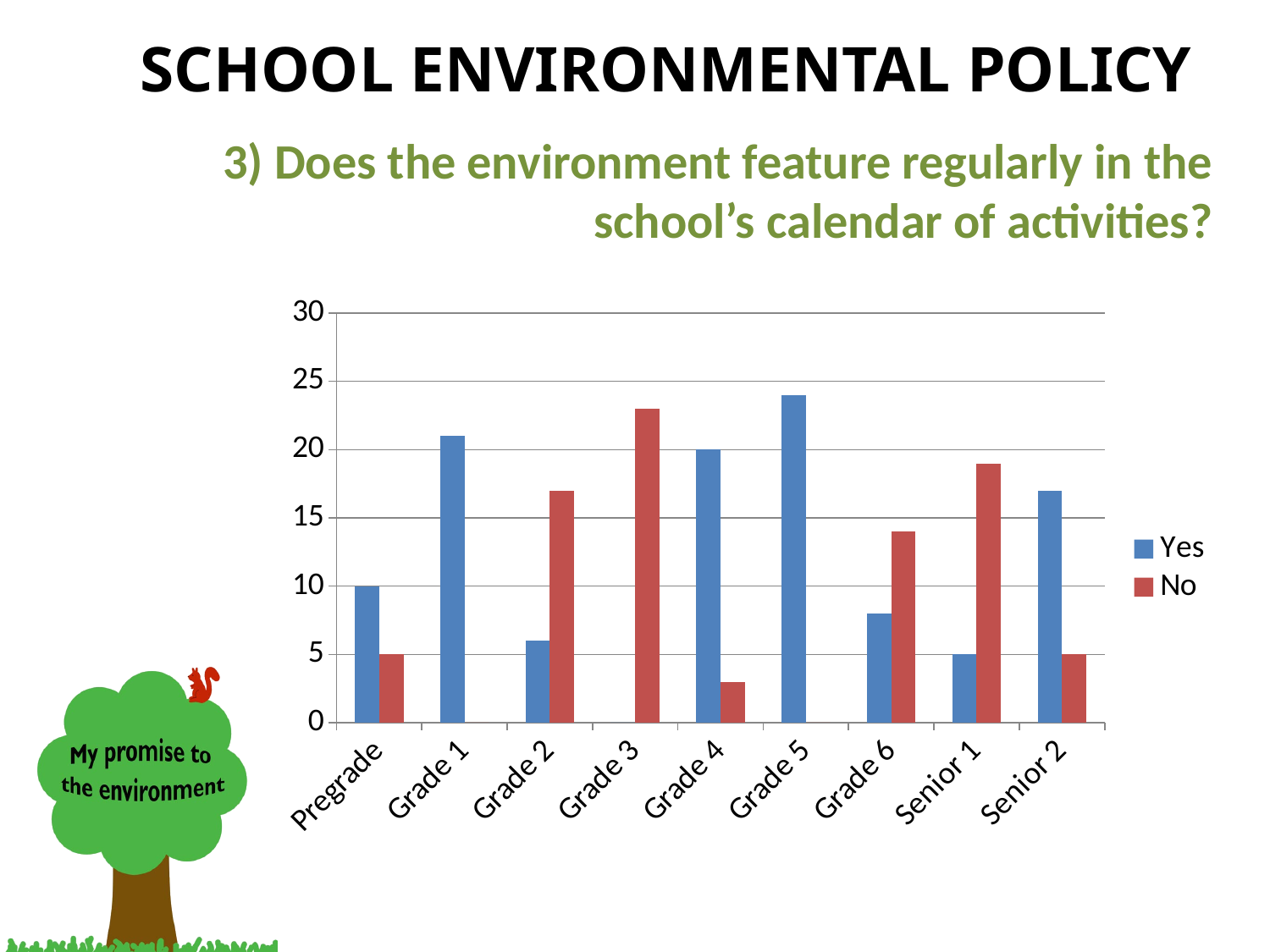
How many grade categories are shown on the x axis? 9 What is the Yes value for Pregrade? 10 What is the Yes value for Grade 4? 20 What is the No value for Senior 2? 5 Which two series are listed in the legend? Yes and No Which grade has the highest No value? Grade 3 Is the Yes value for Grade 1 greater or less than 20? greater For Senior 1, which is larger, the Yes value or the No value? No Is the No value for Grade 6 greater or less than 15? less How many series does the legend list? 2 What kind of chart is shown on the slide? bar chart Which grade has the highest Yes value? Grade 5